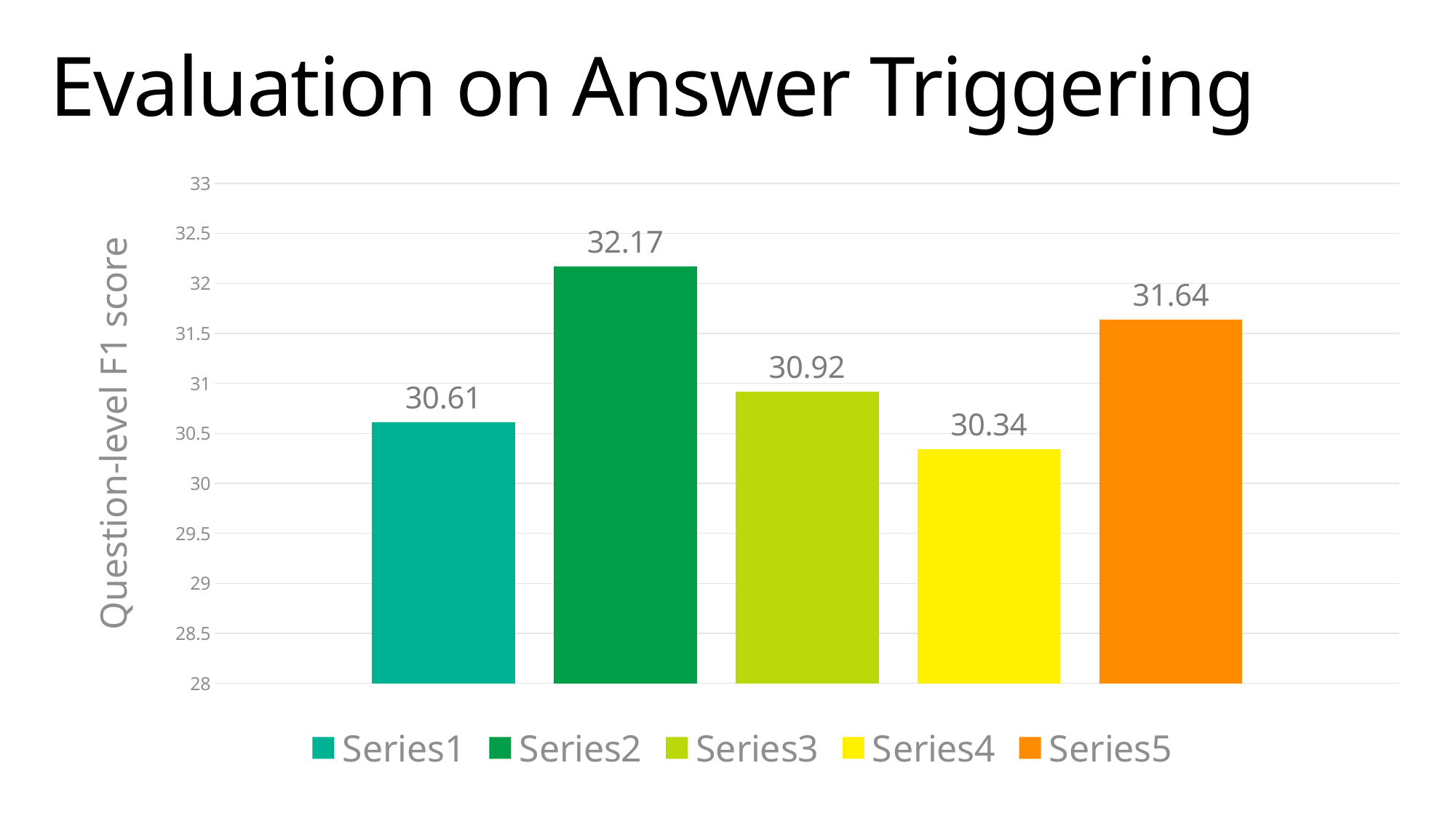
How many series does the legend list? 5 Which series has the highest Question-level F1 score? Series2 Which has a higher F1 score, Series3 or Series5? Series5 Is the value for Series1 greater or less than 31? less What is the Question-level F1 score for Series4? 30.34 How many bars are shown in the chart? 5 What is the Question-level F1 score for Series5? 31.64 Which series has the lowest Question-level F1 score? Series4 What is the difference between the F1 scores of Series5 and Series1? 1.03 What is the Question-level F1 score for Series2? 32.17 What type of chart is shown on the slide? bar chart What is the difference between the F1 scores of Series2 and Series4? 1.83